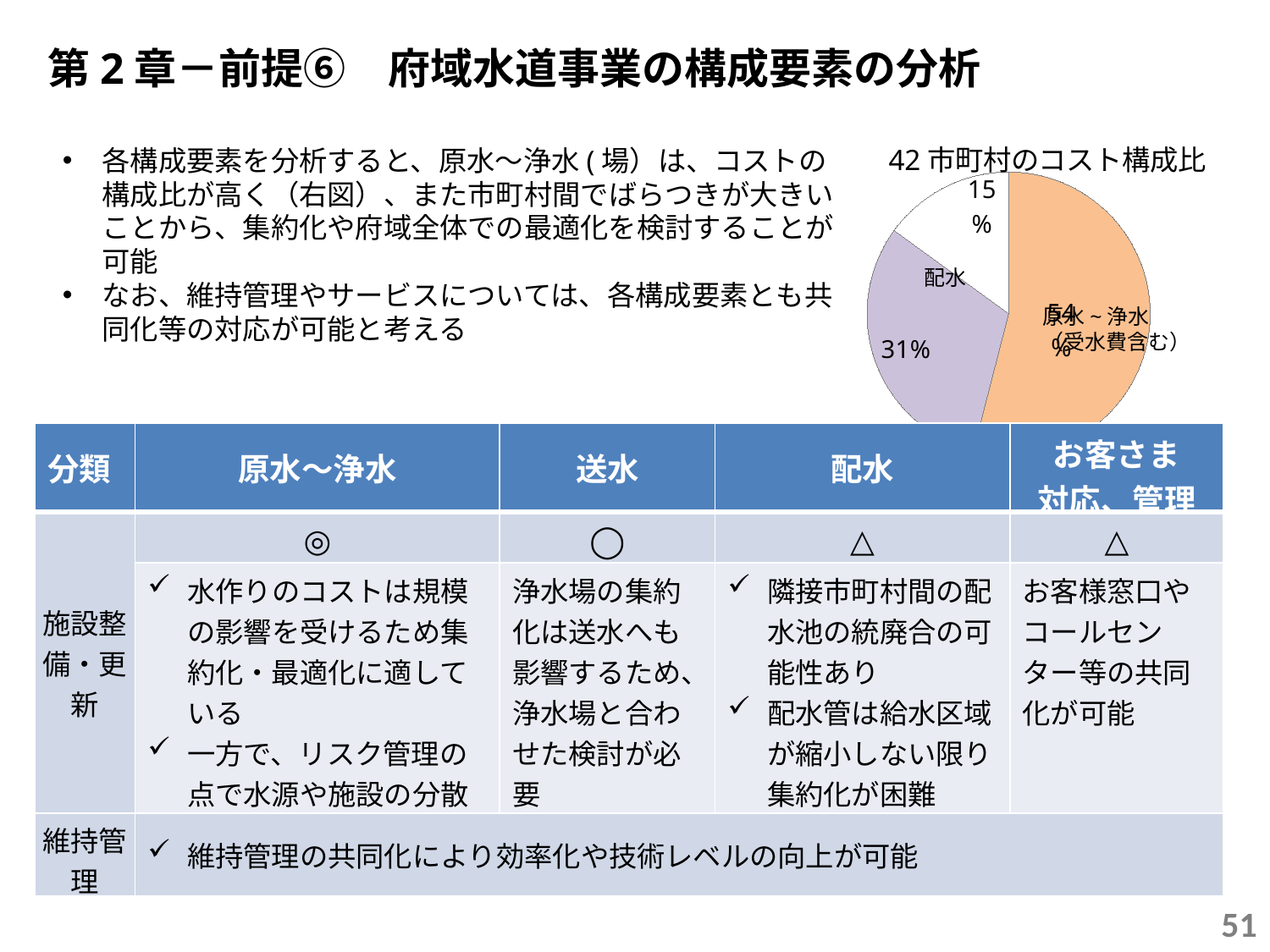
Which slice of the pie chart is the largest? 原水～浄水 What is the percentage shown on the smallest slice of the pie chart? 15% What is the title of the pie chart? 42市町村のコスト構成比 Which is larger in the pie chart, the 配水 slice or the 原水～浄水 slice? 原水～浄水 What is the difference in percentage points between the 配水 slice (31%) and the smallest slice (15%)? 16 What percentage does the 配水 slice represent in the pie chart? 31% What kind of chart is shown on the slide? pie chart How many slices does the pie chart have? 3 Is the 配水 slice greater or less than 50% of the pie? less